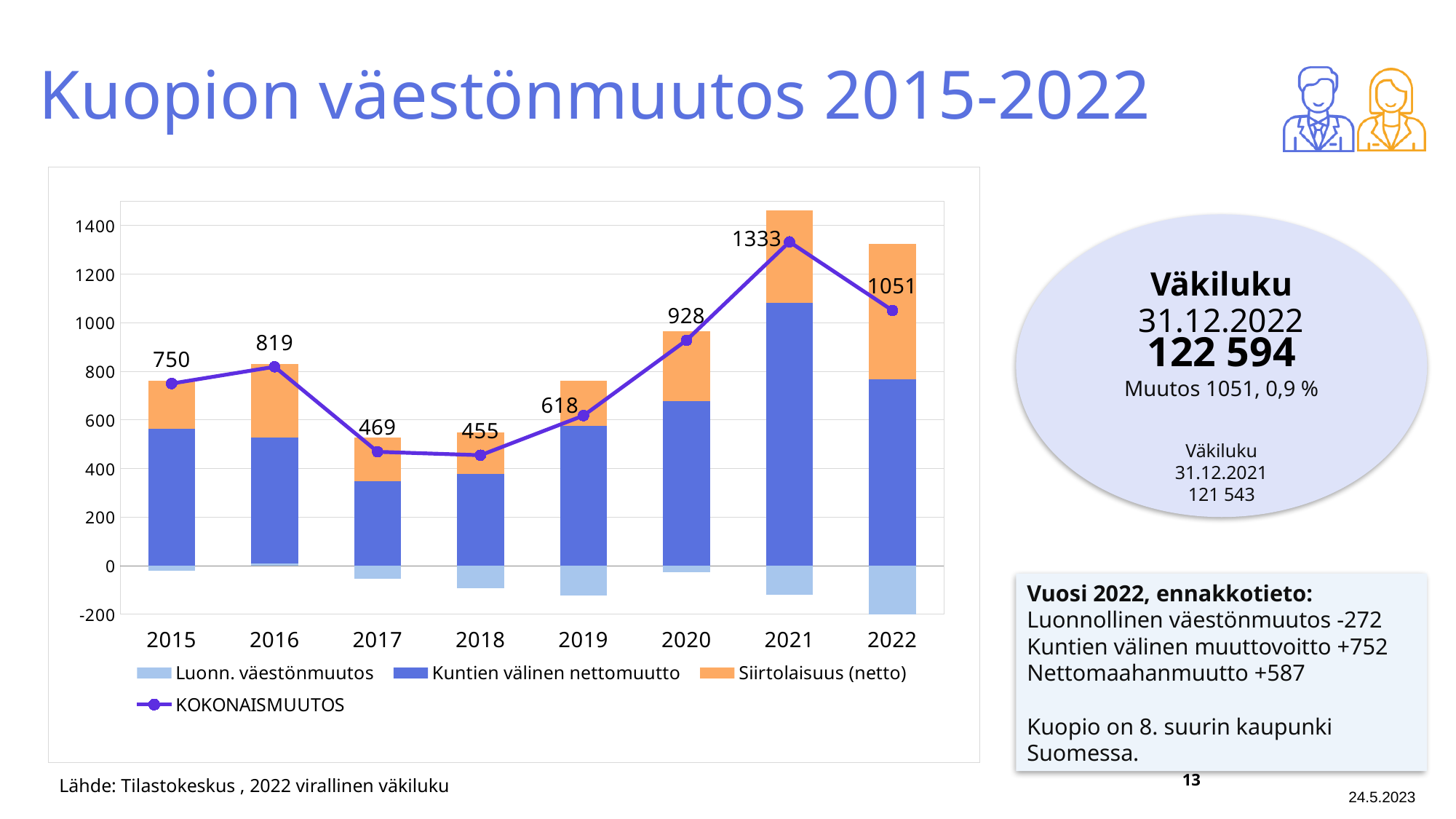
Does the KOKONAISMUUTOS value rise or fall from 2018 to 2021? rise What kind of chart is shown on the slide? Stacked bar chart with a line What is the KOKONAISMUUTOS value for 2021? 1333 Which year has the highest KOKONAISMUUTOS value? 2021 Which year has a larger KOKONAISMUUTOS value, 2016 or 2020? 2020 How many series does the chart legend list? 4 What is the KOKONAISMUUTOS value for 2018? 455 What is the KOKONAISMUUTOS value for 2022? 1051 What is the difference between the KOKONAISMUUTOS values for 2021 and 2022? 282 Which year has the lowest KOKONAISMUUTOS value? 2018 How many years are shown on the x axis of the chart? 8 Is the Kuntien välinen nettomuutto value for 2021 greater or less than 1000? greater